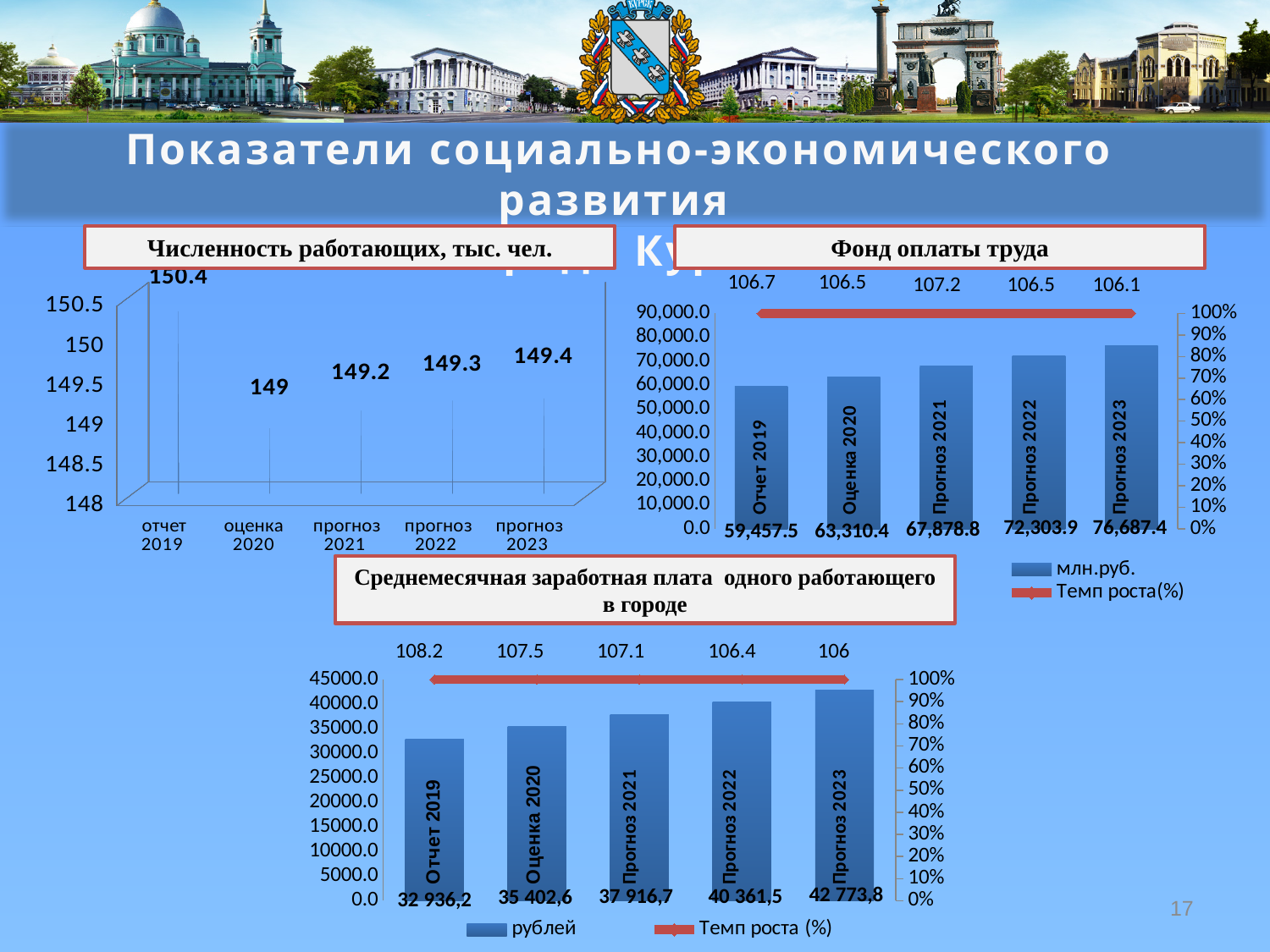
In the chart 'Численность работающих, тыс. чел.', which category has the lowest value? оценка 2020 In the chart 'Фонд оплаты труда', how many series does the legend list? 2 In the chart 'Среднемесячная заработная плата одного работающего в городе', is the рублей value for Прогноз 2022 greater or less than 40000.0? greater In the chart 'Среднемесячная заработная плата одного работающего в городе', what is the рублей value for Оценка 2020? 35 402,6 In the chart 'Численность работающих, тыс. чел.', what is the value for отчет 2019? 150.4 In the chart 'Среднемесячная заработная плата одного работающего в городе', which category has the highest Темп роста (%) value? Отчет 2019 In the chart 'Фонд оплаты труда', do the млн.руб. bar values rise or fall from Отчет 2019 to Прогноз 2023? rise In the chart 'Численность работающих, тыс. чел.', how many categories are shown on the x axis? 5 In the chart 'Фонд оплаты труда', what is the value of the млн.руб. bar for Прогноз 2023? 76,687.4 What kind of chart is 'Среднемесячная заработная плата одного работающего в городе'? bar chart with a line In the chart 'Фонд оплаты труда', which category has the highest млн.руб. value? Прогноз 2023 In the chart 'Фонд оплаты труда', what is the Темп роста(%) value for Прогноз 2021? 107.2